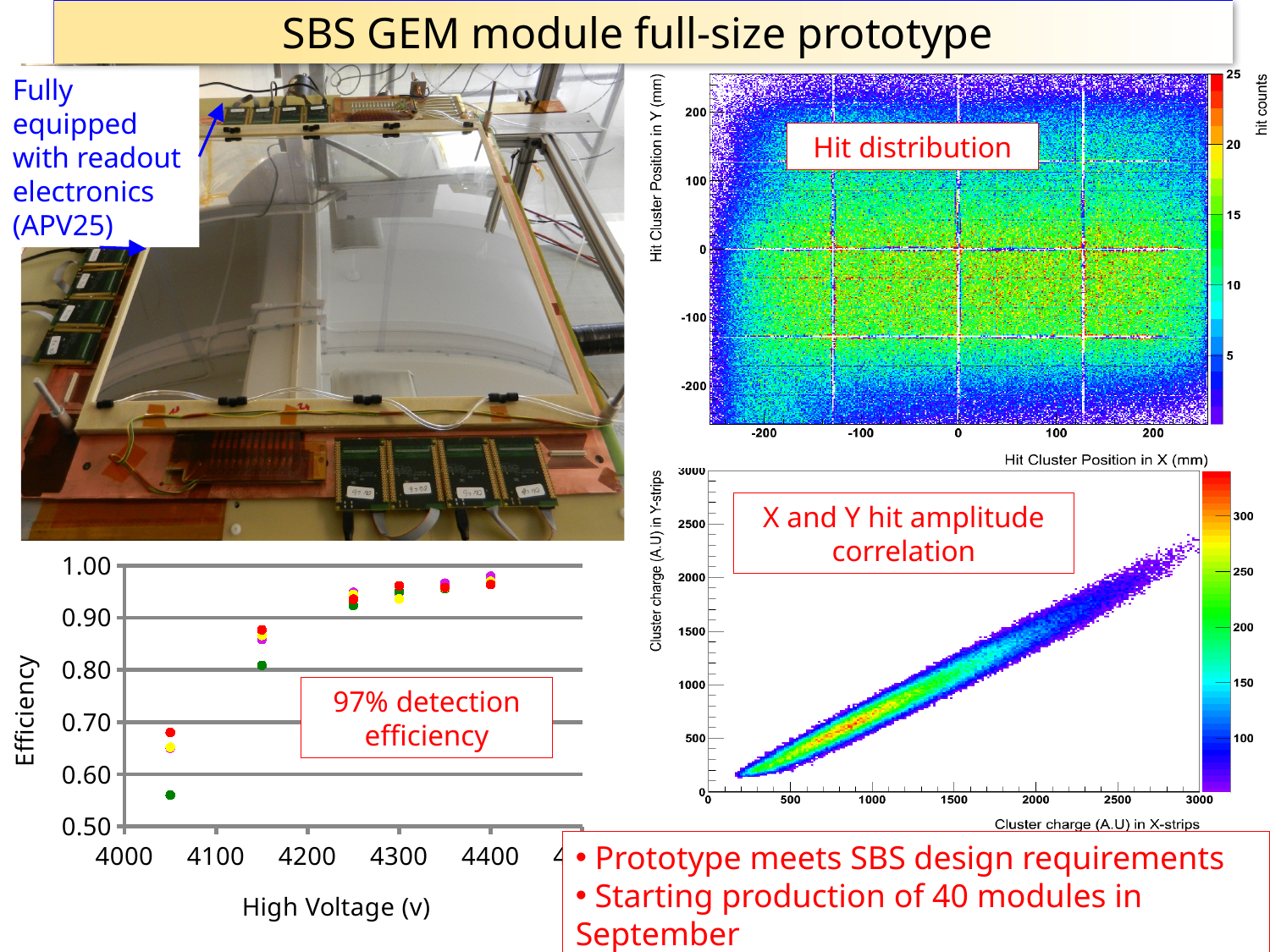
What detection efficiency does the annotation on the Efficiency versus High Voltage chart state? 97% In the Efficiency versus High Voltage chart, how many distinct high-voltage settings have data points plotted? 6 What kind of chart is the Efficiency versus High Voltage chart at the bottom left? scatter plot In the Efficiency versus High Voltage chart, is the lowest efficiency value plotted at 4050 V greater or less than 0.60? less In the Hit distribution chart at the top right, what is the maximum value shown on the hit counts colour scale? 25 In the X and Y hit amplitude correlation chart, does the cluster charge in Y-strips rise or fall as the cluster charge in X-strips increases? rise What is the x-axis title of the Hit distribution chart at the top right? Hit Cluster Position in X (mm) In the Efficiency versus High Voltage chart, are the efficiency values plotted at 4400 V greater or less than 0.90? greater In the Efficiency versus High Voltage chart, which has the larger efficiency values, 4050 V or 4400 V? 4400 V In the Efficiency versus High Voltage chart, are the efficiency values plotted at 4150 V greater or less than 0.90? less In the Efficiency versus High Voltage chart, do the efficiency values rise or fall as the high voltage increases? rise